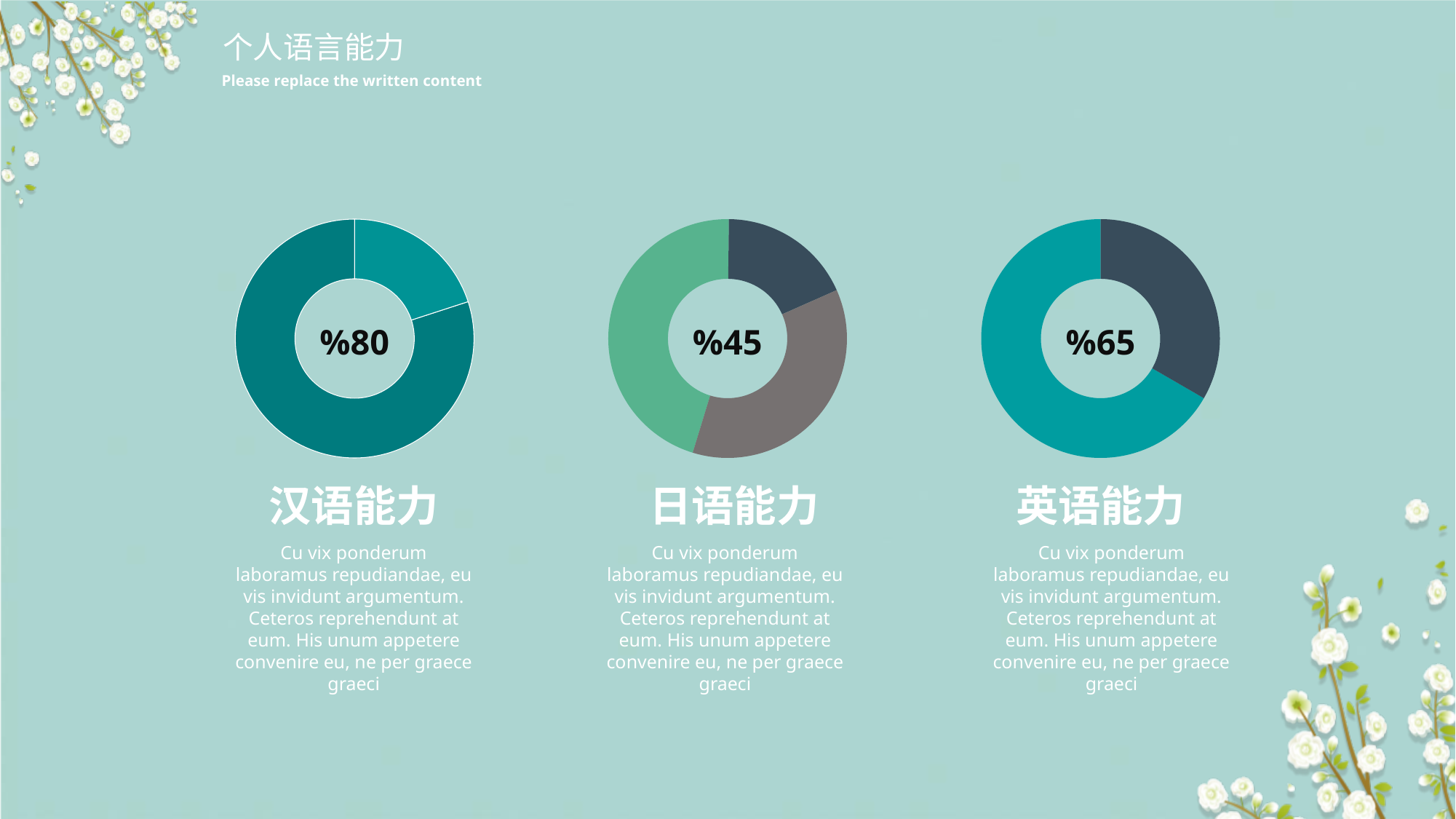
What type of chart is used for the 日语能力 chart? Doughnut chart What is the title of the slide containing the three doughnut charts? 个人语言能力 Which of the three language charts shows the lowest percentage? 日语能力 What percentage is shown in the centre of the 汉语能力 doughnut chart? %80 How many slices does the 日语能力 doughnut chart have? 3 What is the difference between the percentage shown for 汉语能力 and the percentage shown for 日语能力? 35 What percentage is shown in the centre of the 英语能力 doughnut chart? %65 What percentage is shown in the centre of the 日语能力 doughnut chart? %45 What is the difference between the percentage shown for 英语能力 and the percentage shown for 日语能力? 20 Which is larger, the percentage for 英语能力 or the percentage for 日语能力? 英语能力 How many doughnut charts are on the slide? 3 Which of the three language charts shows the highest percentage? 汉语能力